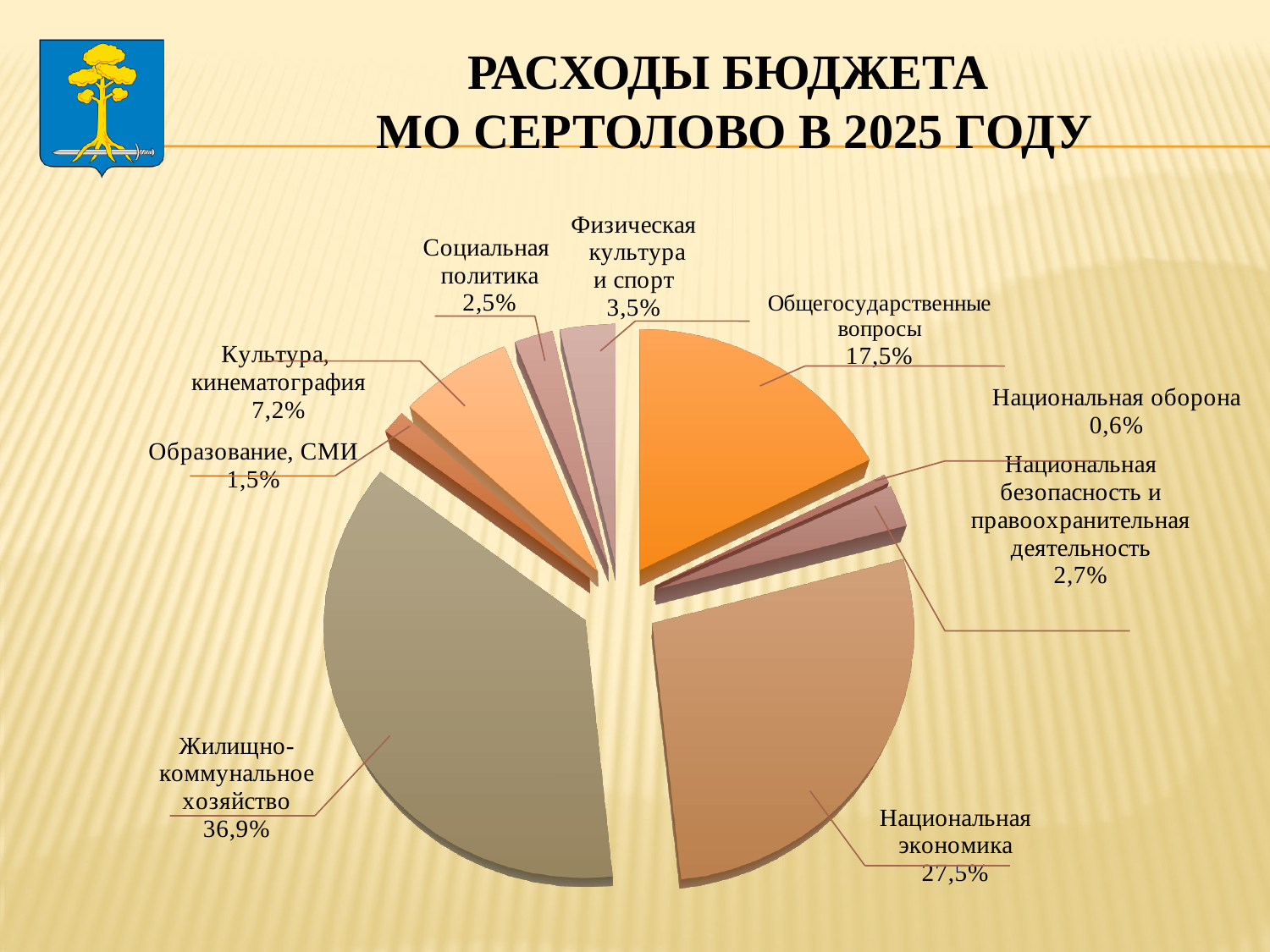
Какая доля расходов приходится на национальную оборону? 0,6% Какая доля расходов приходится на общегосударственные вопросы? 17,5% Как называется диаграмма на слайде? Расходы бюджета МО Сертолово в 2025 году Какой тип диаграммы показан на слайде? Круговая диаграмма Какая доля расходов бюджета приходится на жилищно-коммунальное хозяйство? 36,9% Какая статья расходов имеет наибольшую долю в бюджете? Жилищно-коммунальное хозяйство Сколько статей расходов показано на диаграмме? 9 На сколько процентных пунктов доля жилищно-коммунального хозяйства больше доли национальной экономики? 9,4 Что больше: доля социальной политики или доля физической культуры и спорта? Физическая культура и спорт Какая доля расходов приходится на культуру и кинематографию? 7,2% Какая статья расходов имеет наименьшую долю в бюджете? Национальная оборона Какая доля расходов приходится на национальную экономику? 27,5%